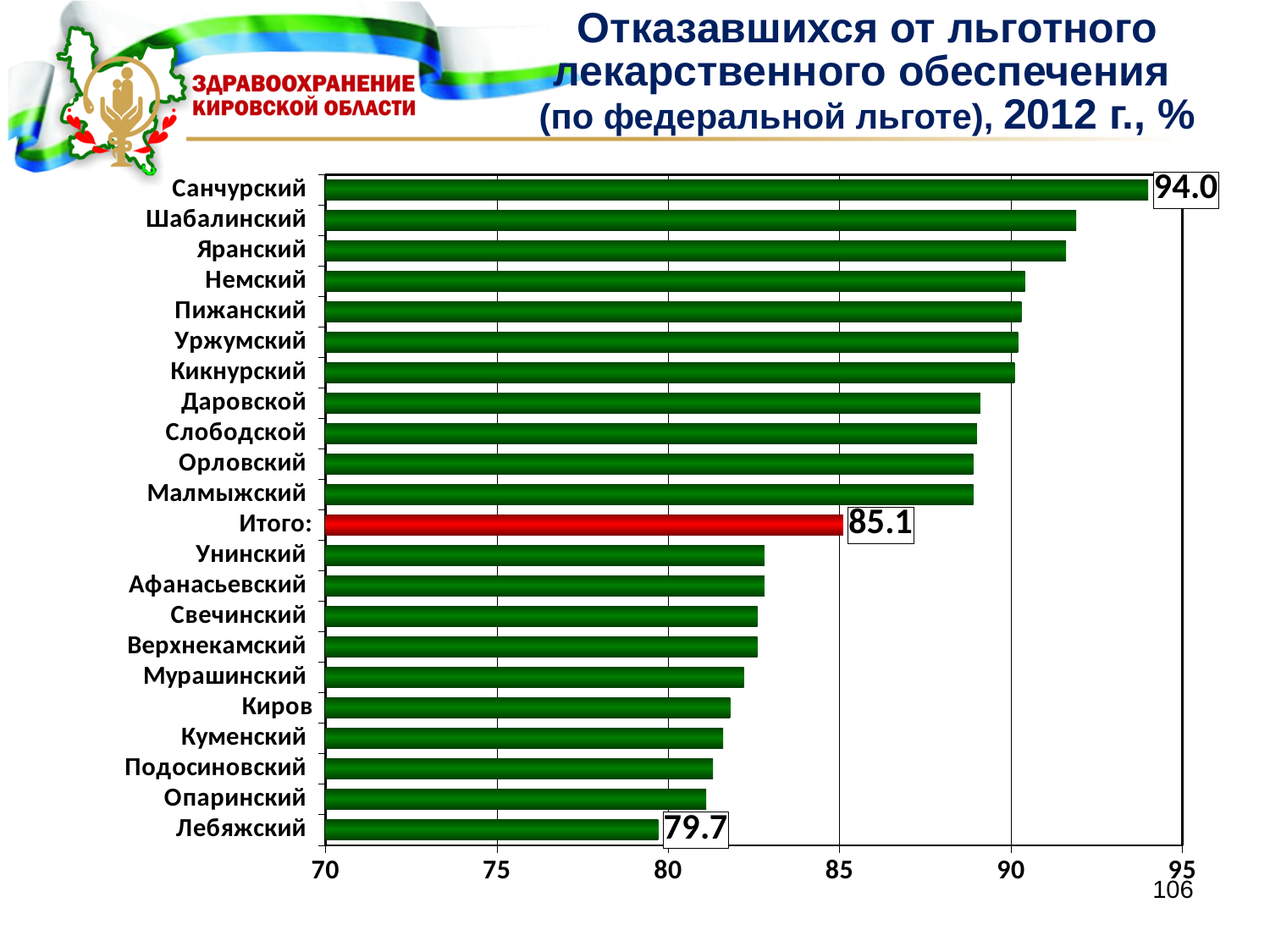
What is the value for Санчурский? 94.0 What is the value for Итого:? 85.1 Which category has the highest value? Санчурский Is the value for Шабалинский greater or less than 90? greater How many categories are shown on the chart? 22 Which category has the lowest value? Лебяжский Is the value for Киров greater or less than 85? less What is the difference between the values for Санчурский and Лебяжский? 14.3 What kind of chart is shown on the slide? bar chart What is the value for Лебяжский? 79.7 What is the difference between the values for Санчурский and Итого:? 8.9 Which is larger, the value for Яранский or the value for Куменский? Яранский